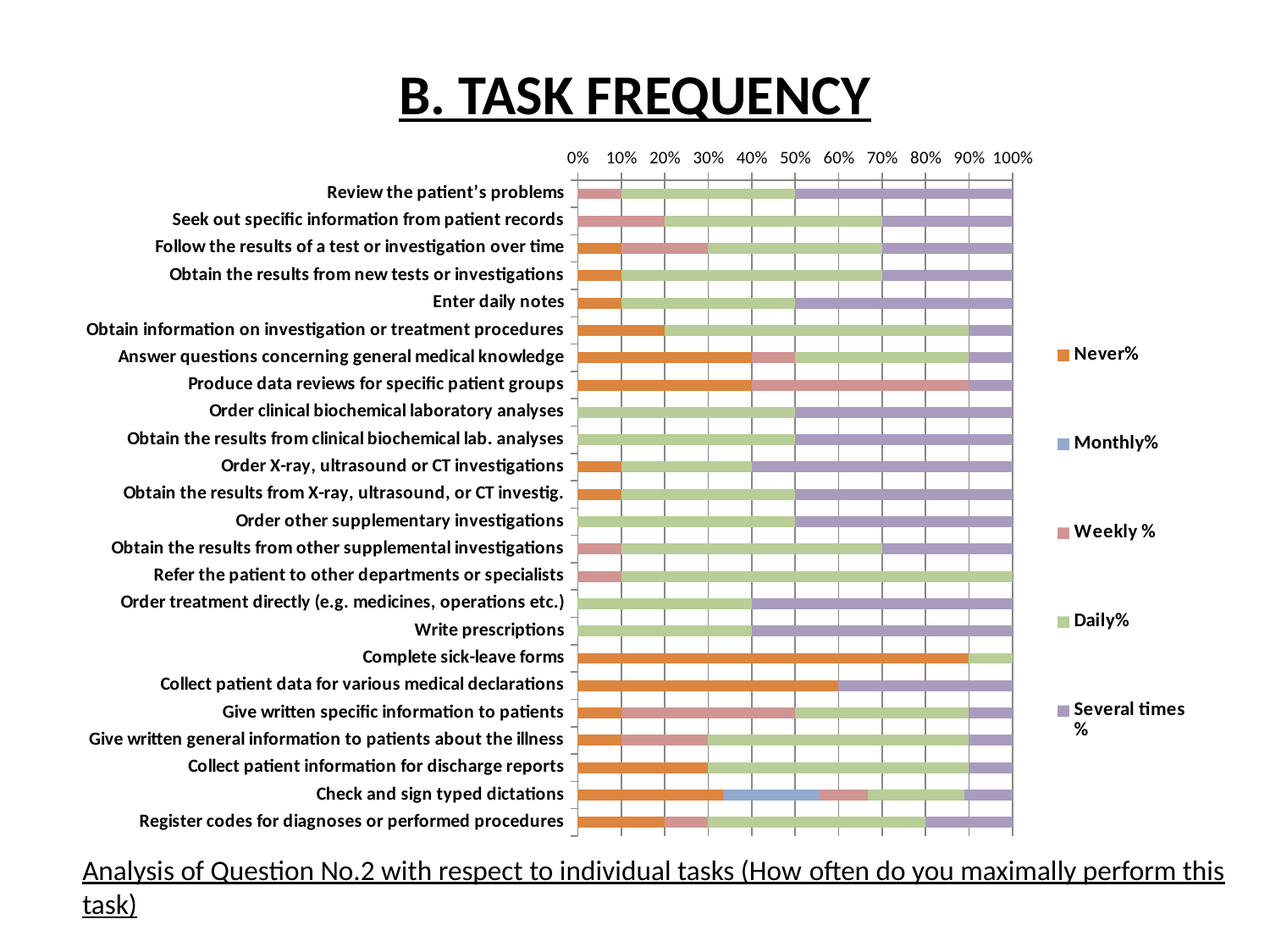
Is the Never% value for 'Collect patient data for various medical declarations' greater or less than 50%? greater How many series does the legend list? 5 What is the title of the slide's chart section? B. TASK FREQUENCY Which has the larger Daily% segment: 'Refer the patient to other departments or specialists' or 'Write prescriptions'? Refer the patient to other departments or specialists How many task categories are plotted on the chart? 24 Which has the larger Never% segment: 'Complete sick-leave forms' or 'Collect patient data for various medical declarations'? Complete sick-leave forms What kind of chart is shown on the slide? Stacked bar chart Is the Never% value for 'Complete sick-leave forms' greater or less than 80%? greater Which task has the largest Never% segment? Complete sick-leave forms Is the Never% value for 'Produce data reviews for specific patient groups' greater or less than 30%? greater Which legend entry is shown in blue? Monthly%